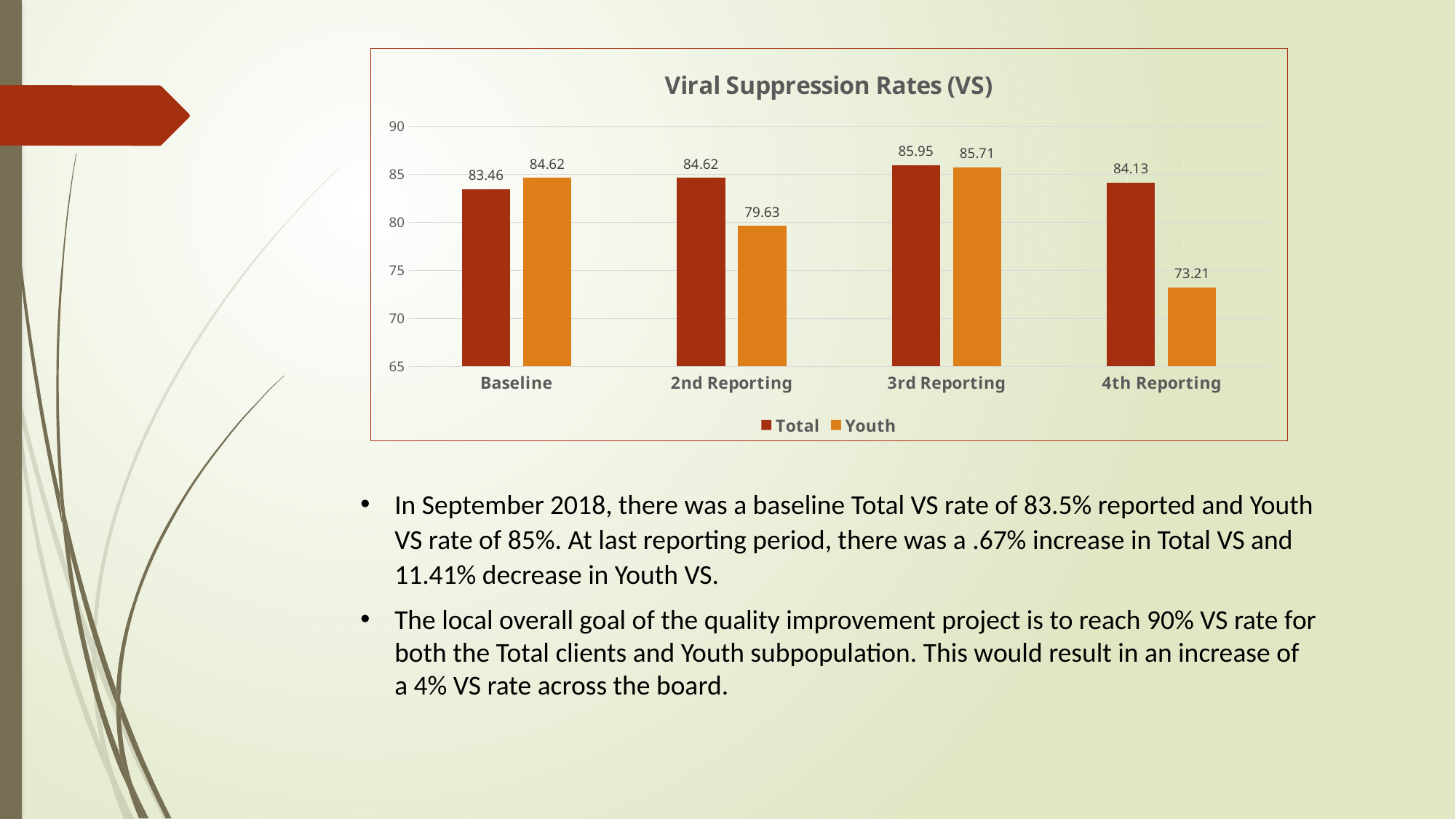
What is the Youth viral suppression rate at the 4th Reporting period? 73.21 How many series does the legend list? 2 Is the Youth value at the 3rd Reporting period greater or less than 85? greater At the 2nd Reporting period, which is larger, the Total or the Youth value? Total What kind of chart is shown on the slide? Bar chart How many reporting periods are shown on the x axis? 4 What is the title of the chart? Viral Suppression Rates (VS) What is the Youth value at the 2nd Reporting period? 79.63 What is the Total viral suppression rate at Baseline? 83.46 Which reporting period has the highest Total viral suppression rate? 3rd Reporting Which reporting period has the lowest Youth viral suppression rate? 4th Reporting What is the difference between the Total and Youth values at the 4th Reporting period? 10.92